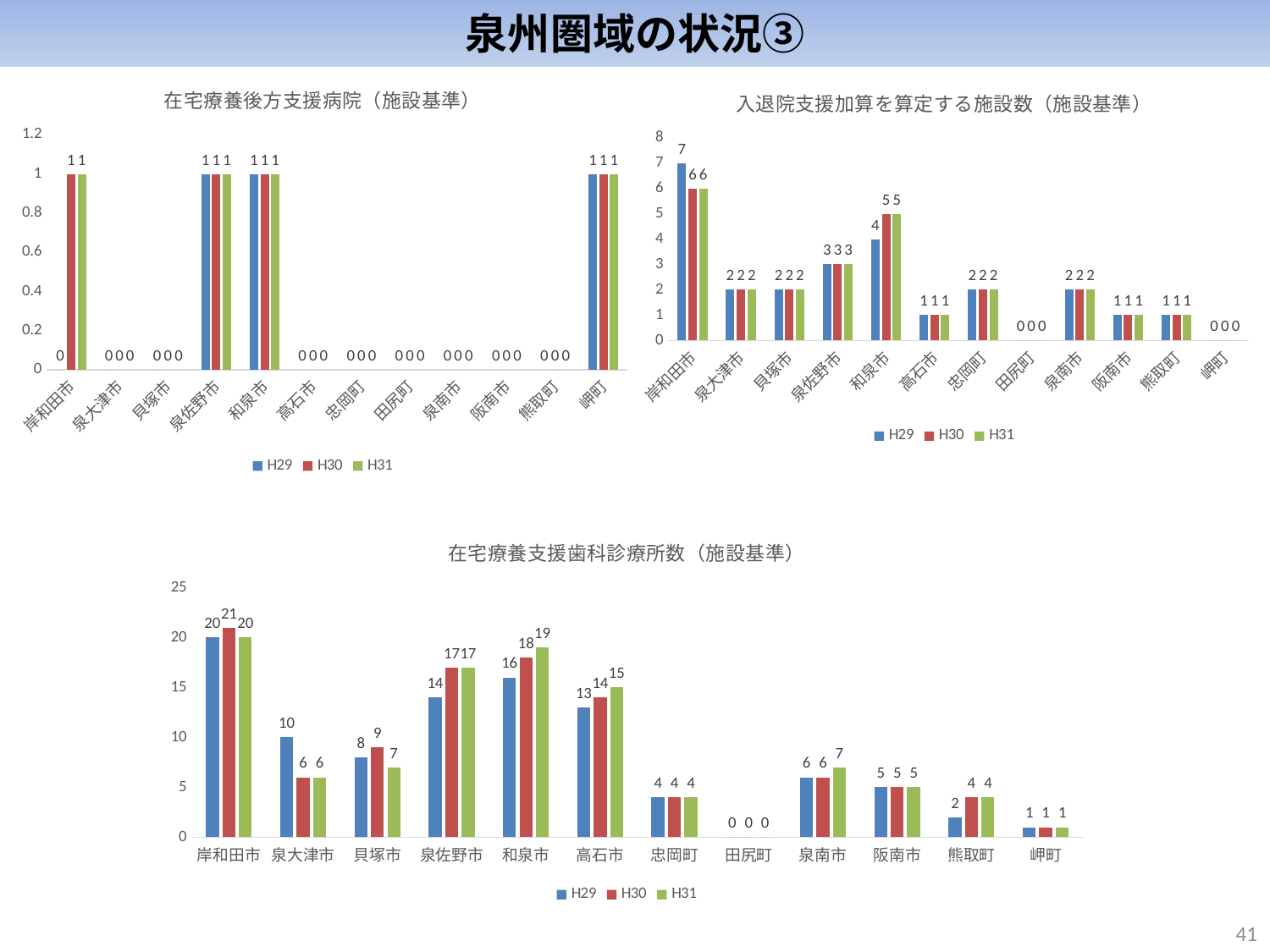
What kind of chart is the chart titled 在宅療養支援歯科診療所数（施設基準）? bar chart In the chart titled 在宅療養支援歯科診療所数（施設基準）, which is larger, the H31 value for 泉佐野市 or the H31 value for 高石市? 泉佐野市 In the chart titled 入退院支援加算を算定する施設数（施設基準）, how many series does the legend list? 3 In the chart titled 在宅療養支援歯科診療所数（施設基準）, which category has the lowest values across all three years? 田尻町 In the chart titled 入退院支援加算を算定する施設数（施設基準）, what is the difference between the H29 and H31 values for 和泉市? 1 In the chart titled 在宅療養支援歯科診療所数（施設基準）, what is the H30 value for 岸和田市? 21 In the chart titled 在宅療養支援歯科診療所数（施設基準）, what is the H31 value for 和泉市? 19 In the chart titled 在宅療養支援歯科診療所数（施設基準）, what is the difference between the H29 and H30 values for 泉大津市? 4 In the chart titled 在宅療養後方支援病院（施設基準）, how many categories are shown on the x axis? 12 In the chart titled 入退院支援加算を算定する施設数（施設基準）, which category has the highest H30 value? 岸和田市 In the chart titled 入退院支援加算を算定する施設数（施設基準）, what is the H29 value for 岸和田市? 7 In the chart titled 在宅療養後方支援病院（施設基準）, what is the H29 value for 岸和田市? 0